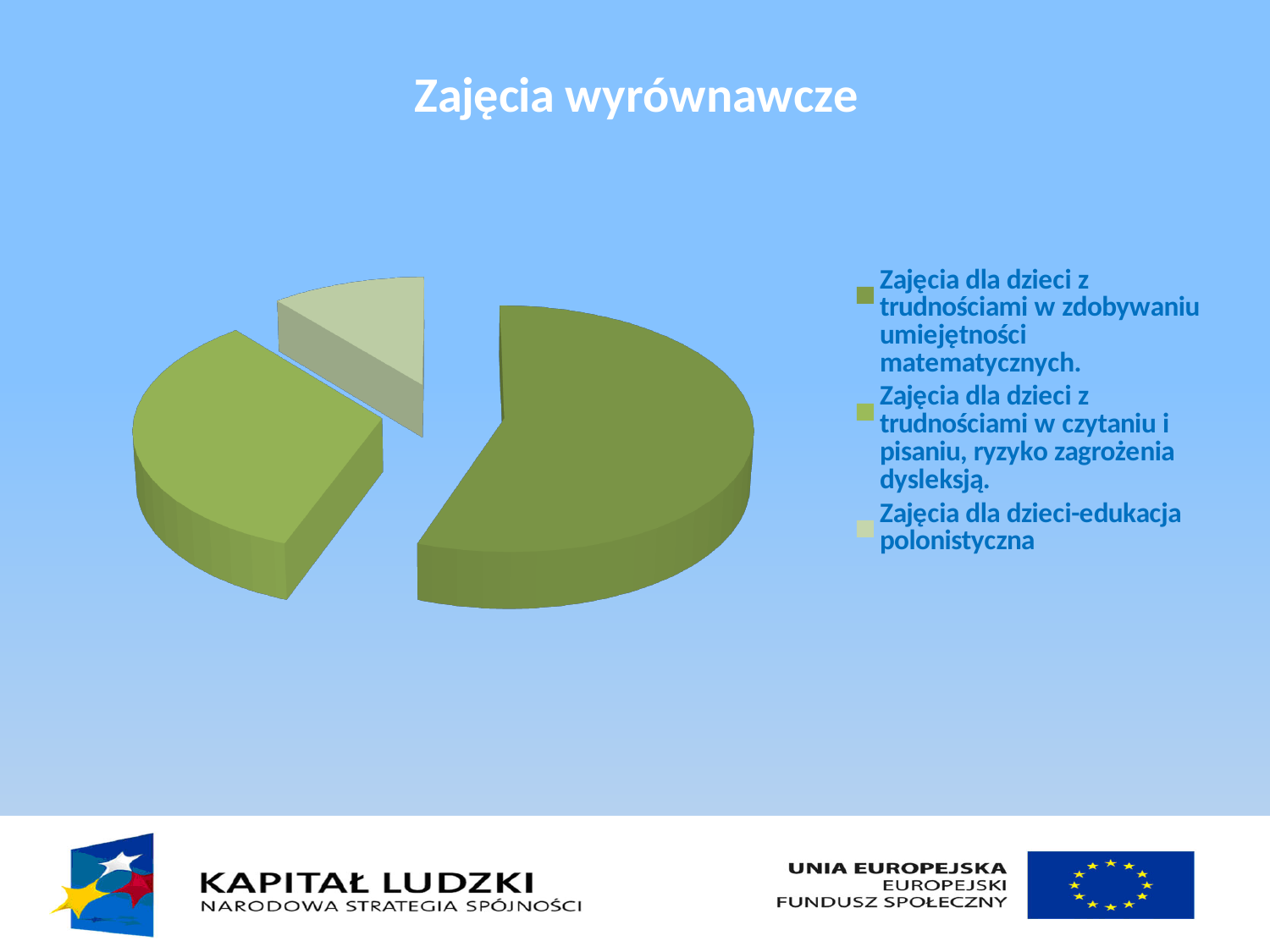
What is the title of the slide containing the pie chart? Zajęcia wyrównawcze How many slices does the pie chart have? 3 How many entries does the legend of the pie chart list? 3 Which slice is larger: 'Zajęcia dla dzieci z trudnościami w zdobywaniu umiejętności matematycznych.' or 'Zajęcia dla dzieci z trudnościami w czytaniu i pisaniu, ryzyko zagrożenia dysleksją.'? Zajęcia dla dzieci z trudnościami w zdobywaniu umiejętności matematycznych. What kind of chart is shown on the slide? Pie chart Which legend entry is shown with the lightest colour in the pie chart? Zajęcia dla dzieci-edukacja polonistyczna Which slice is larger: 'Zajęcia dla dzieci z trudnościami w czytaniu i pisaniu, ryzyko zagrożenia dysleksją.' or 'Zajęcia dla dzieci-edukacja polonistyczna'? Zajęcia dla dzieci z trudnościami w czytaniu i pisaniu, ryzyko zagrożenia dysleksją. Which category has the smallest slice of the pie chart? Zajęcia dla dzieci-edukacja polonistyczna Which category has the largest slice of the pie chart? Zajęcia dla dzieci z trudnościami w zdobywaniu umiejętności matematycznych.